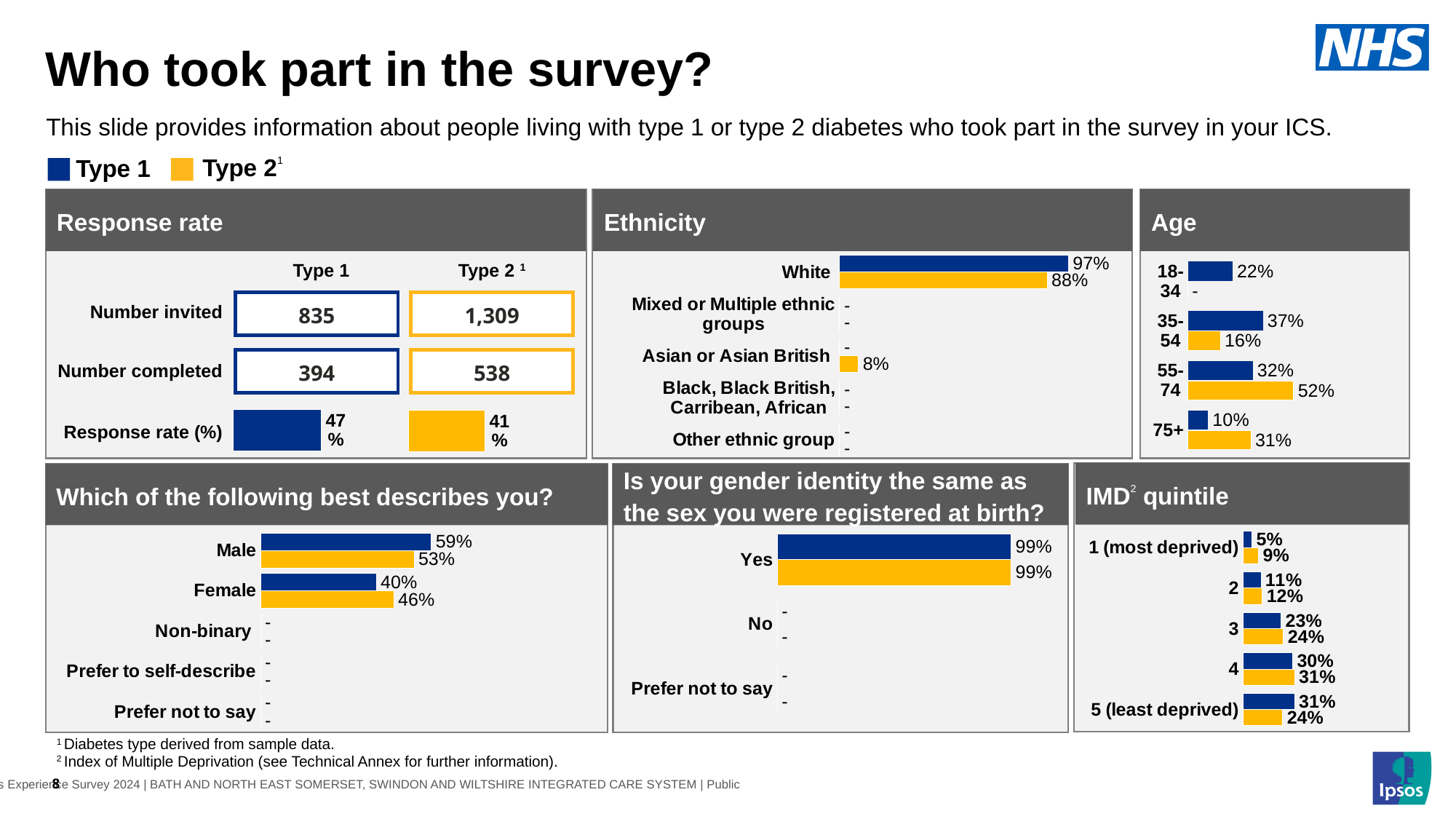
In the Response rate panel, what is the number completed for Type 2? 538 In the 'Which of the following best describes you?' chart, what is the Type 2 value for Female? 46% In the Age chart, what is the difference between the Type 1 and Type 2 values for 75+? 21% In the Ethnicity chart, what is the Type 2 value for Asian or Asian British? 8% In the Age chart, what is the Type 2 value for 55-74? 52% In the 'Which of the following best describes you?' chart, which is larger for Type 1: Male or Female? Male In the IMD quintile chart, what is the Type 1 value for 5 (least deprived)? 31% How many series does the legend at the top of the slide list? 2 In the IMD quintile chart, which quintile has the lowest Type 2 value? 1 (most deprived) In the Response rate panel, what is the difference between the number invited for Type 2 and Type 1? 474 In the Ethnicity chart, what is the Type 1 value for White? 97% In the Age chart, which age group has the highest Type 1 value? 35-54